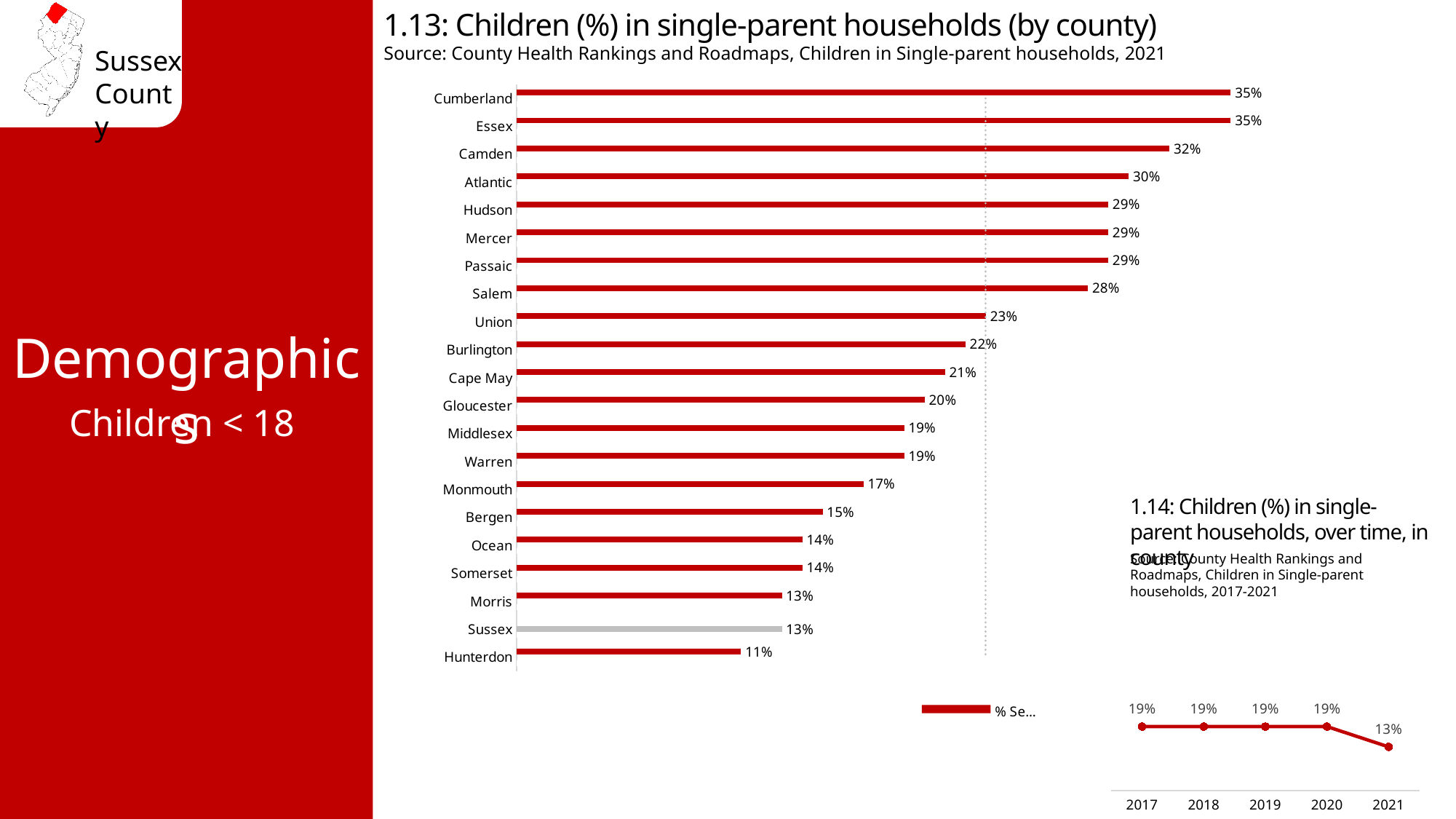
In chart 1.14 (over time, in county), how many years are plotted? 5 In chart 1.14 (over time, in county), do the values rise or fall from 2020 to 2021? Fall What kind of chart is chart 1.13 (by county)? Bar chart In chart 1.13 (by county), which county has the lowest value? Hunterdon In chart 1.13 (by county), what is the difference between Cumberland and Hunterdon? 24% In chart 1.13 (by county), how many counties are plotted? 21 In chart 1.14 (over time, in county), what is the value for 2021? 13% In chart 1.13 (by county), which is larger, the value for Union or the value for Monmouth? Union In chart 1.13 (by county), which bar is coloured grey instead of red? Sussex In chart 1.13 (Children in single-parent households by county), what is the value for Sussex? 13% In chart 1.14 (over time, in county), what is the value for 2017? 19% In chart 1.13 (by county), what is the value for Camden? 32%